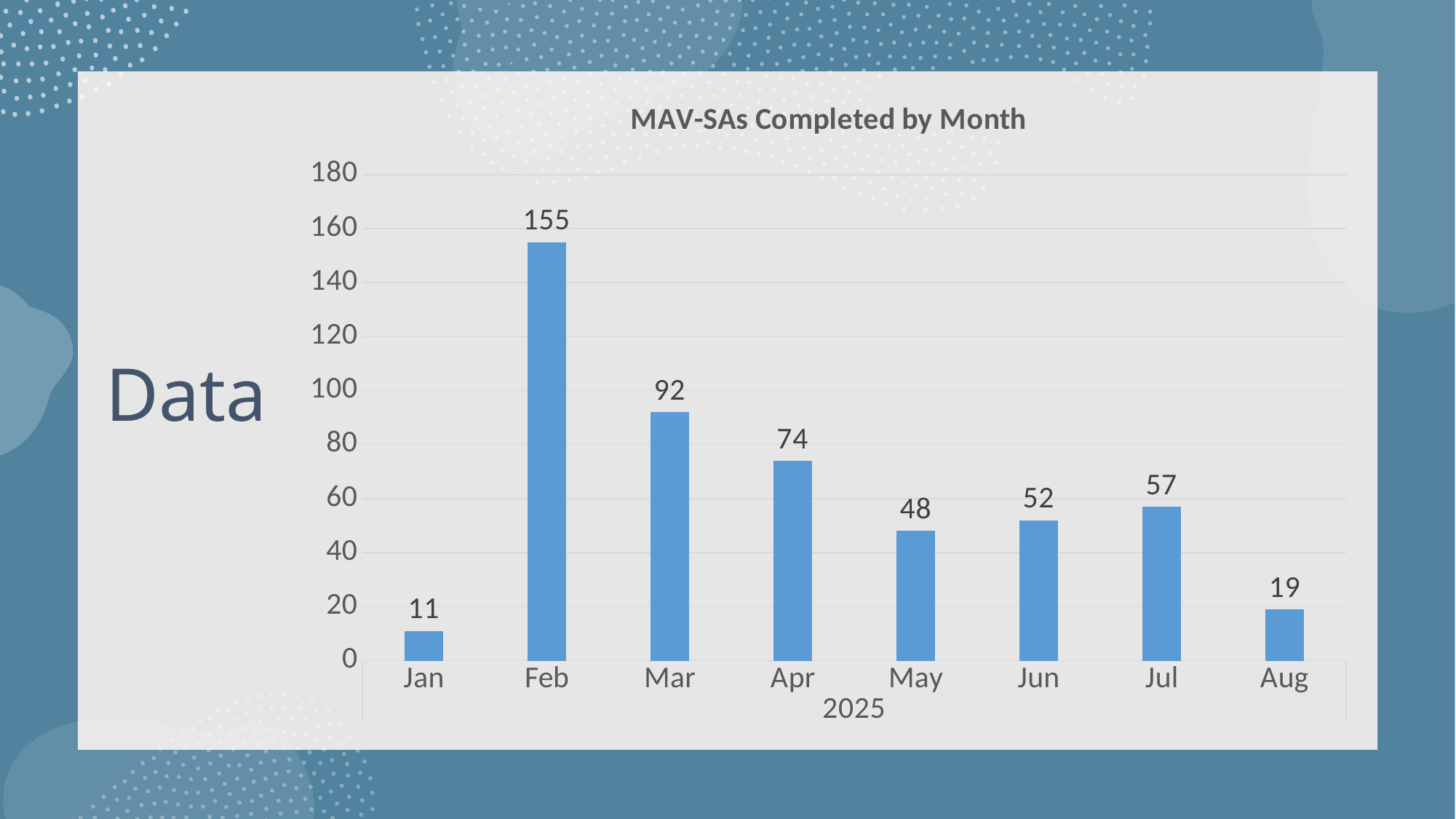
Is the value for Mar greater or less than 100? less What kind of chart is shown? bar chart Which month has the highest value? Feb What is the value for May? 48 How many months are shown on the x axis? 8 Which is larger, the value for Apr or the value for Jul? Apr What is the value for Feb? 155 What is the title of the chart? MAV-SAs Completed by Month Which month has the lowest value? Jan What is the difference between the values for Jul and Jun? 5 What is the value for Aug? 19 What is the difference between the values for Feb and Mar? 63